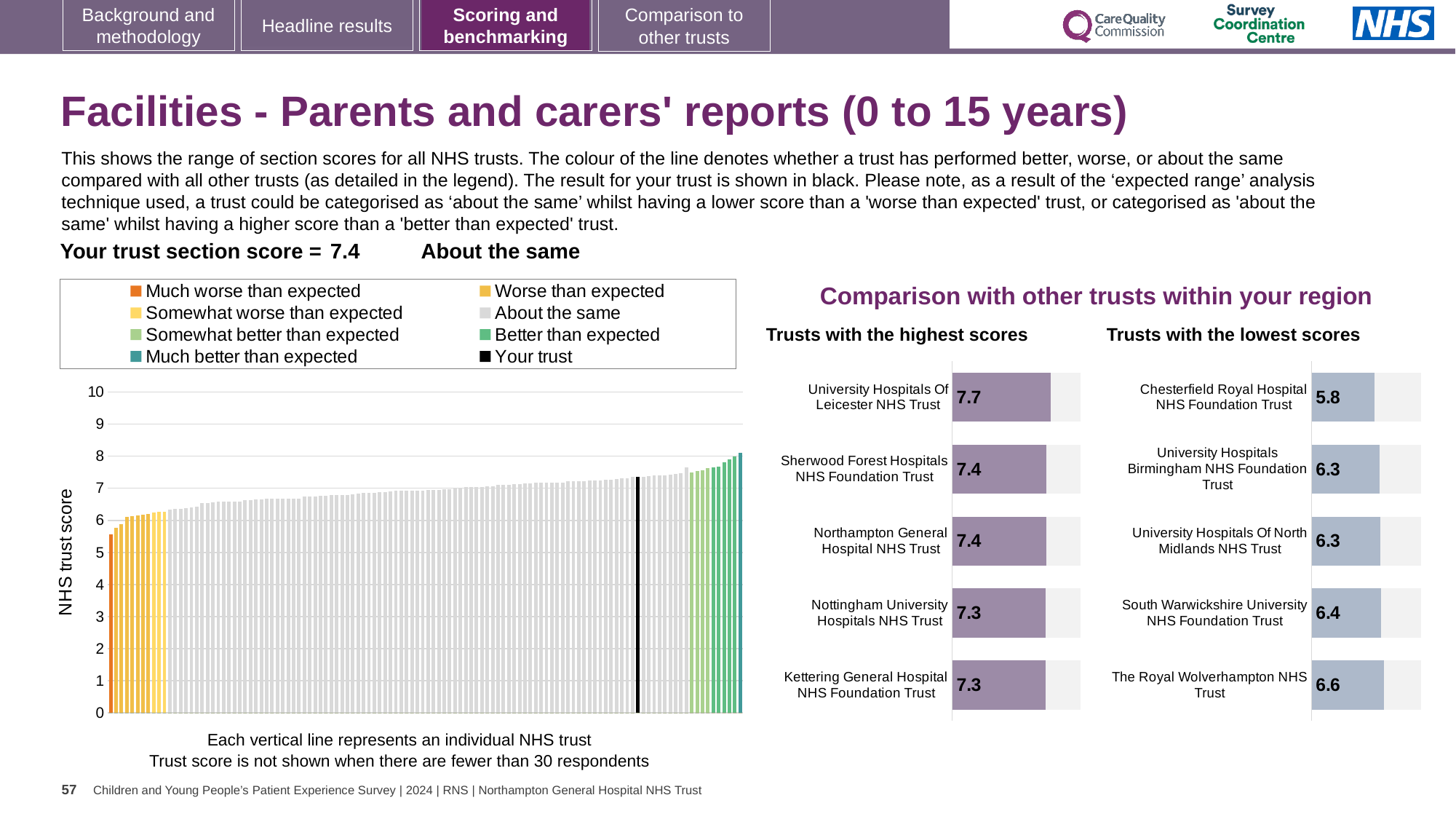
Which has the higher score: Nottingham University Hospitals NHS Trust in the 'Trusts with the highest scores' chart or South Warwickshire University NHS Foundation Trust in the 'Trusts with the lowest scores' chart? Nottingham University Hospitals NHS Trust In the 'Trusts with the lowest scores' chart, what is the score for Chesterfield Royal Hospital NHS Foundation Trust? 5.8 In the main NHS trust score chart on the left, do the trust scores rise or fall from left to right? Rise How many entries does the legend of the main NHS trust score chart on the left list? 8 How many trusts are listed in the 'Trusts with the highest scores' chart? 5 In the 'Trusts with the lowest scores' chart, which trust has the lowest score? Chesterfield Royal Hospital NHS Foundation Trust In the 'Trusts with the lowest scores' chart, what is the difference between the scores of The Royal Wolverhampton NHS Trust and Chesterfield Royal Hospital NHS Foundation Trust? 0.8 In the 'Trusts with the highest scores' chart, which trust has the highest score? University Hospitals Of Leicester NHS Trust In the 'Trusts with the highest scores' chart, what is the score for University Hospitals Of Leicester NHS Trust? 7.7 What kind of chart is the main NHS trust score chart on the left of the slide? Bar chart In the 'Trusts with the highest scores' chart, what is the difference between the scores of University Hospitals Of Leicester NHS Trust and Kettering General Hospital NHS Foundation Trust? 0.4 In the 'Trusts with the lowest scores' chart, what is the score for The Royal Wolverhampton NHS Trust? 6.6